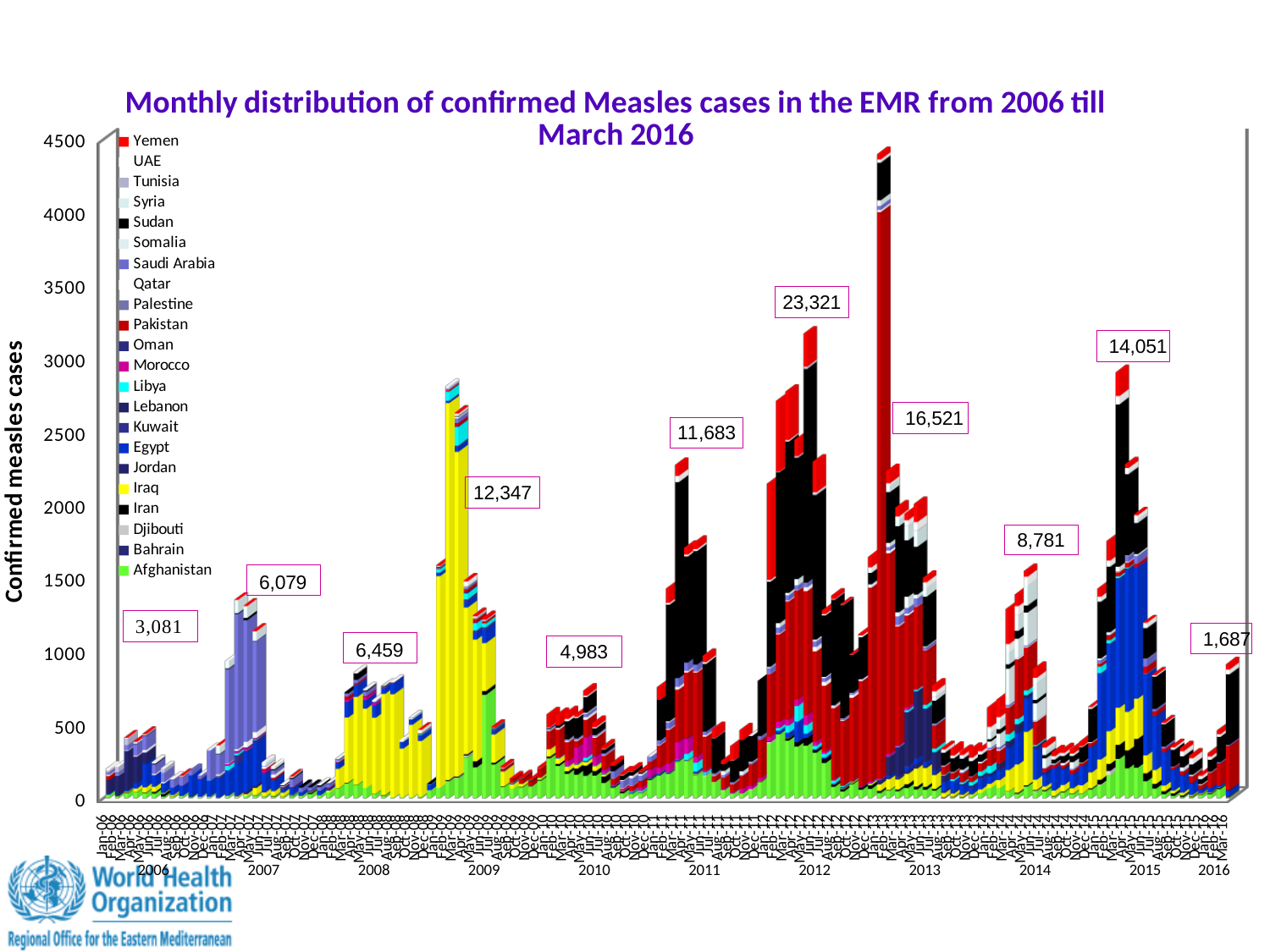
What annual total is labelled for 2016 (up to March)? 1,687 What type of chart is shown on the slide? Stacked bar chart What is the difference between the labelled annual totals for 2012 and 2013? 6,800 What is the label on the vertical axis of the chart? Confirmed measles cases Which labelled annual total is larger, 2009 or 2011? 2009 How many countries does the legend list? 22 Which year has the highest labelled annual total of confirmed measles cases? 2012 What annual total of confirmed measles cases is labelled for 2009? 12,347 What annual total is labelled for 2006? 3,081 What is the difference between the labelled annual totals for 2015 and 2014? 5,270 Is the tallest monthly bar (in early 2013) greater or less than 4000 cases? greater What annual total of confirmed measles cases is labelled for 2012? 23,321